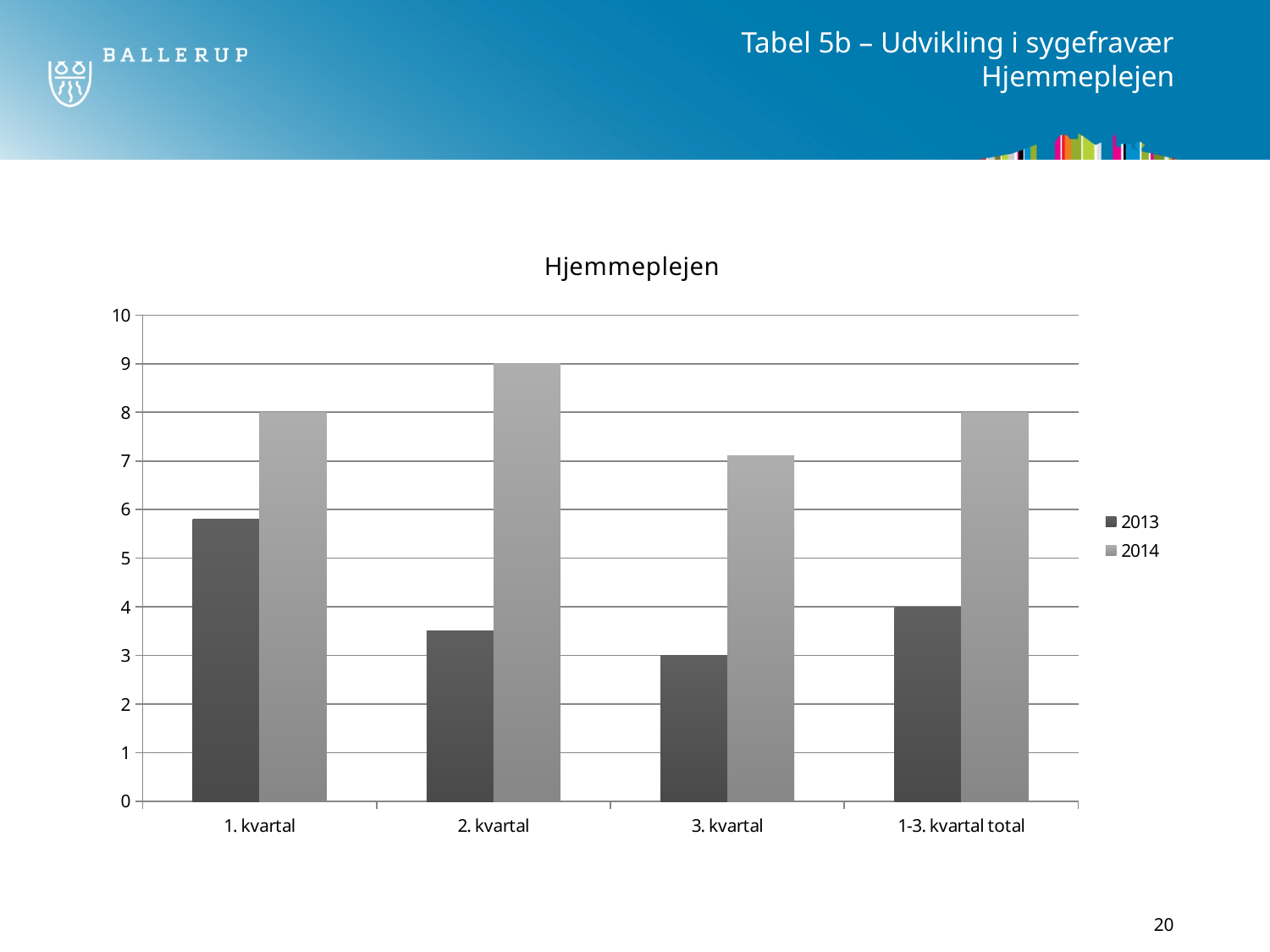
In 1-3. kvartal total, which series has the larger value, 2013 or 2014? 2014 Is the value for 2014 in 3. kvartal greater or less than 8? less What is the value for 2014 in 1. kvartal? 8 Which category has the lowest value for the 2013 series? 3. kvartal Which category has the highest value for the 2014 series? 2. kvartal How many series does the legend list? 2 What is the value for 2013 in 1-3. kvartal total? 4 What type of chart is shown on the slide? bar chart Is the value for 2013 in 1. kvartal greater or less than 5? greater What is the value for 2014 in 2. kvartal? 9 What is the value for 2013 in 3. kvartal? 3 How many categories are shown on the x axis? 4